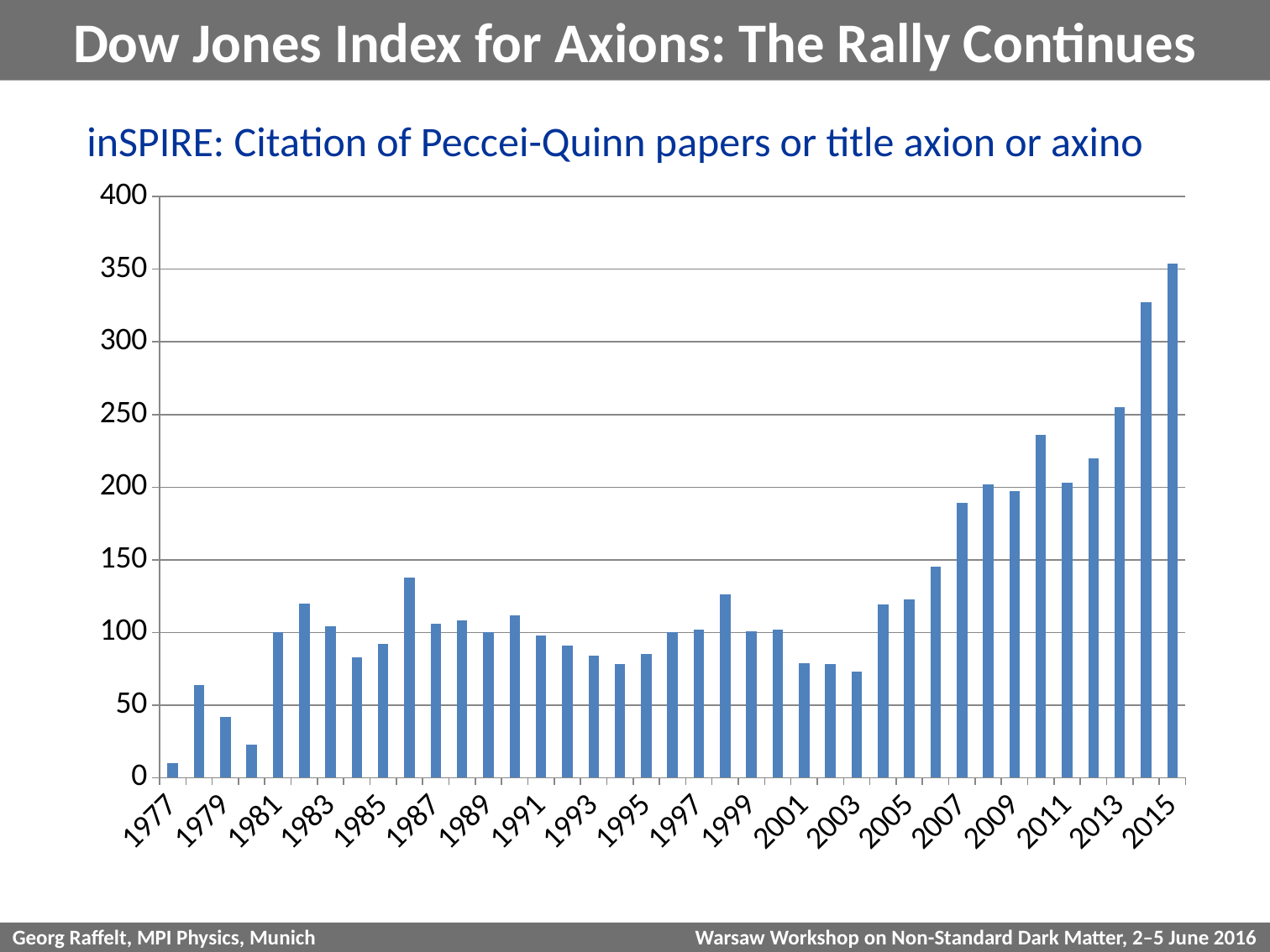
Is the value for 1977 greater or less than 50? less Do the values generally rise or fall from 2003 to 2015? rise Is the value for 2003 greater or less than 100? less Is the value for 2009 greater or less than 150? greater Which year has the larger value, 1985 or 1987? 1987 What kind of chart is shown on the slide? bar chart Which year has the highest value in the chart? 2015 Which year has the larger value, 2013 or 2015? 2015 What is the subtitle printed above the chart? inSPIRE: Citation of Peccei-Quinn papers or title axion or axino Which year has the lowest value in the chart? 1977